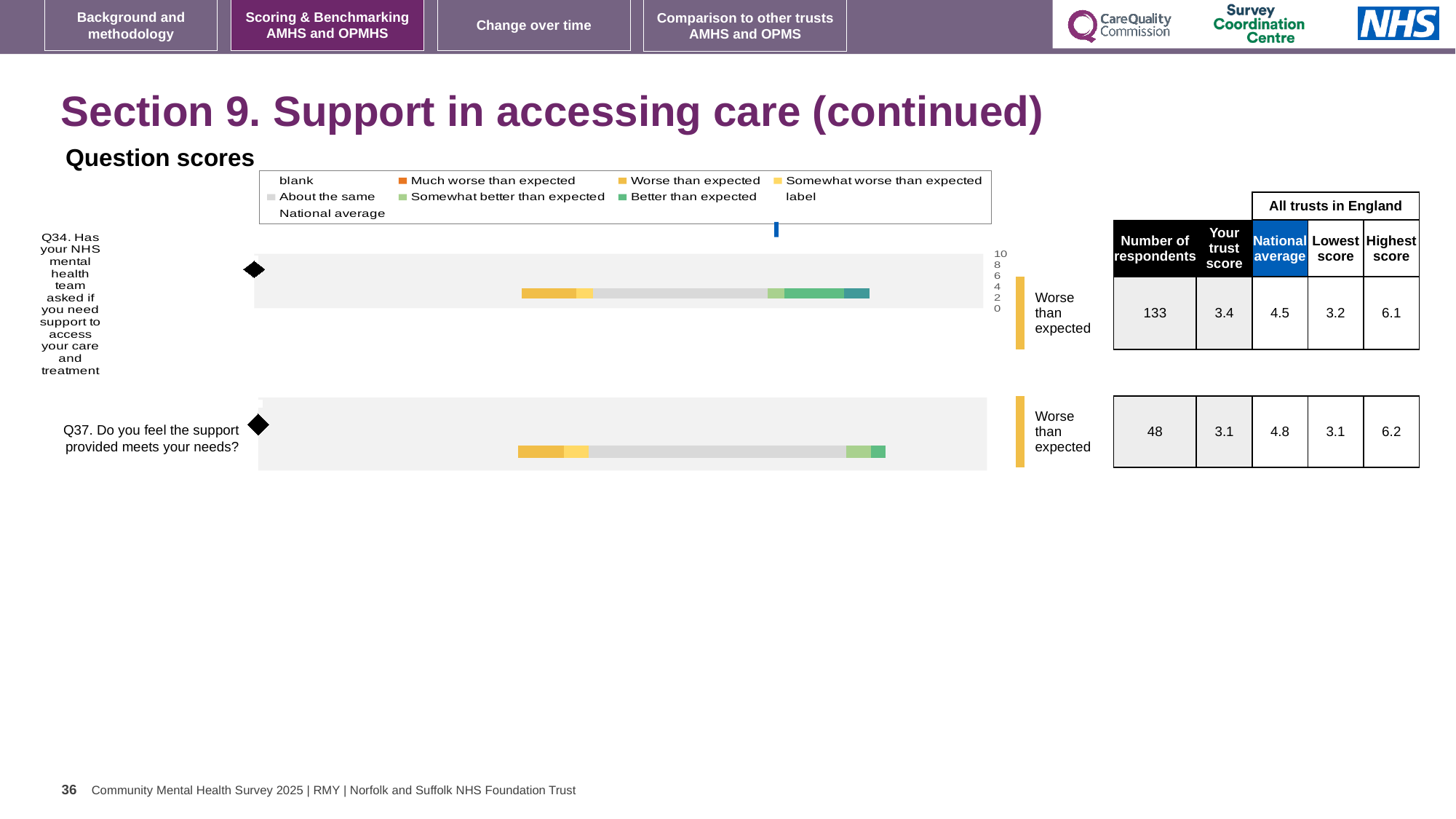
Which legend entry is shown in grey in the question scores chart? About the same What rating label is shown next to the bar for Q37 in the question scores chart? Worse than expected Which legend entry is shown in dark orange in the question scores chart? Much worse than expected How many entries does the legend of the question scores chart list? 9 What is the highest tick value shown on the axis of the question scores chart? 10 How many questions are plotted in the question scores chart? 2 What rating label is shown next to the bar for Q34 in the question scores chart? Worse than expected What kind of chart is used to show the question scores on this slide? bar chart